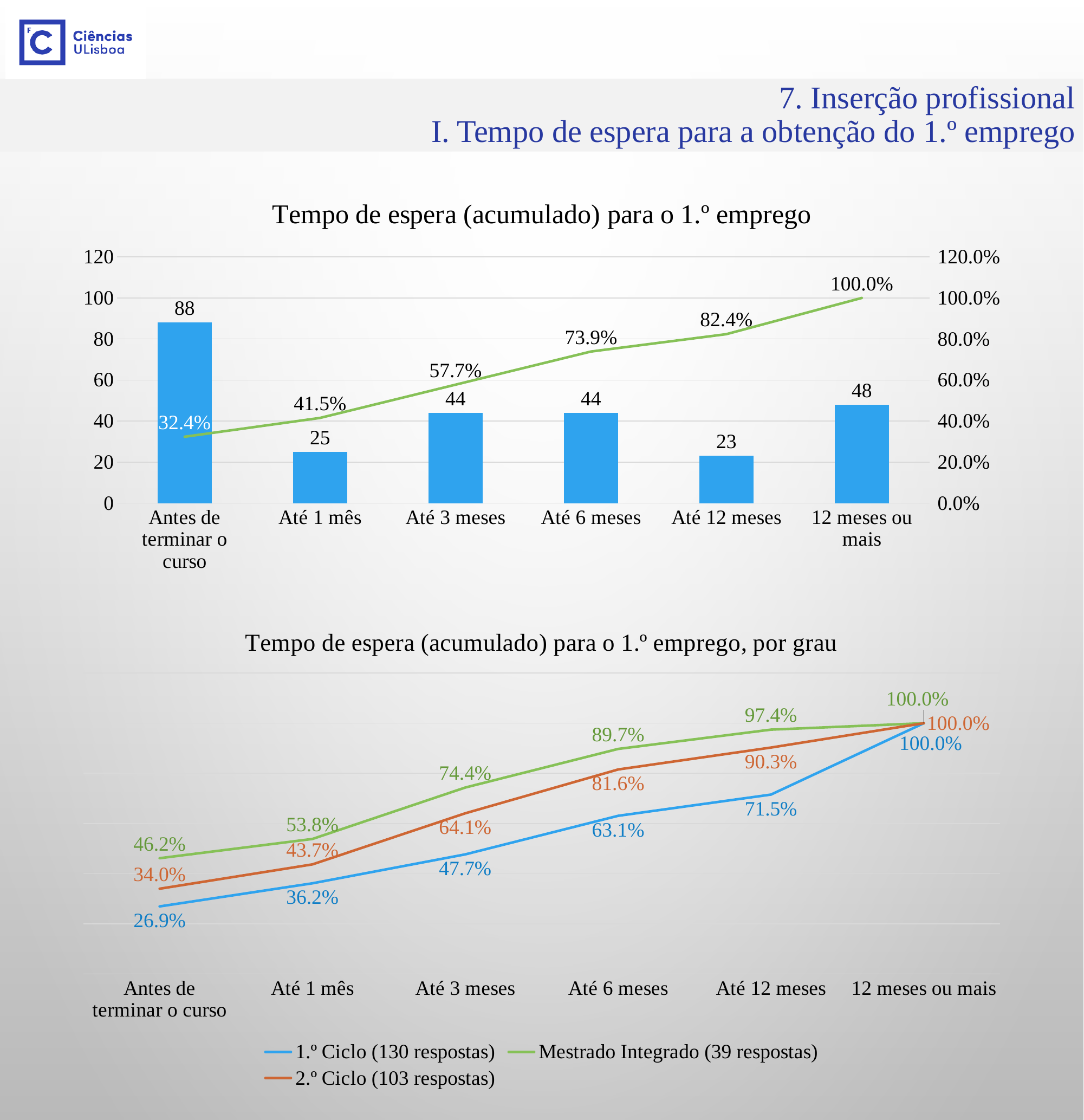
In the chart 'Tempo de espera (acumulado) para o 1.º emprego', what is the bar value for 'Antes de terminar o curso'? 88 In the chart 'Tempo de espera (acumulado) para o 1.º emprego, por grau', what is the value for '1.º Ciclo (130 respostas)' at 'Até 3 meses'? 47.7% In the chart 'Tempo de espera (acumulado) para o 1.º emprego', what is the cumulative percentage at 'Até 6 meses'? 73.9% In the chart 'Tempo de espera (acumulado) para o 1.º emprego', what is the difference between the bar values for 'Antes de terminar o curso' and '12 meses ou mais'? 40 In the chart 'Tempo de espera (acumulado) para o 1.º emprego', which category has the lowest bar value? Até 12 meses In the chart 'Tempo de espera (acumulado) para o 1.º emprego', does the cumulative percentage line rise or fall along the x axis? rise In the chart 'Tempo de espera (acumulado) para o 1.º emprego', which category has the highest bar value? Antes de terminar o curso In the chart 'Tempo de espera (acumulado) para o 1.º emprego', how many categories are shown on the x axis? 6 In the chart 'Tempo de espera (acumulado) para o 1.º emprego, por grau', what is the value for 'Mestrado Integrado (39 respostas)' at 'Até 12 meses'? 97.4% In the chart 'Tempo de espera (acumulado) para o 1.º emprego, por grau', how many series does the legend list? 3 In the chart 'Tempo de espera (acumulado) para o 1.º emprego, por grau', what is the difference between the 'Mestrado Integrado (39 respostas)' and '1.º Ciclo (130 respostas)' values at 'Antes de terminar o curso'? 19.3% In the chart 'Tempo de espera (acumulado) para o 1.º emprego, por grau', which series has the larger value at 'Até 1 mês': '2.º Ciclo (103 respostas)' or '1.º Ciclo (130 respostas)'? 2.º Ciclo (103 respostas)